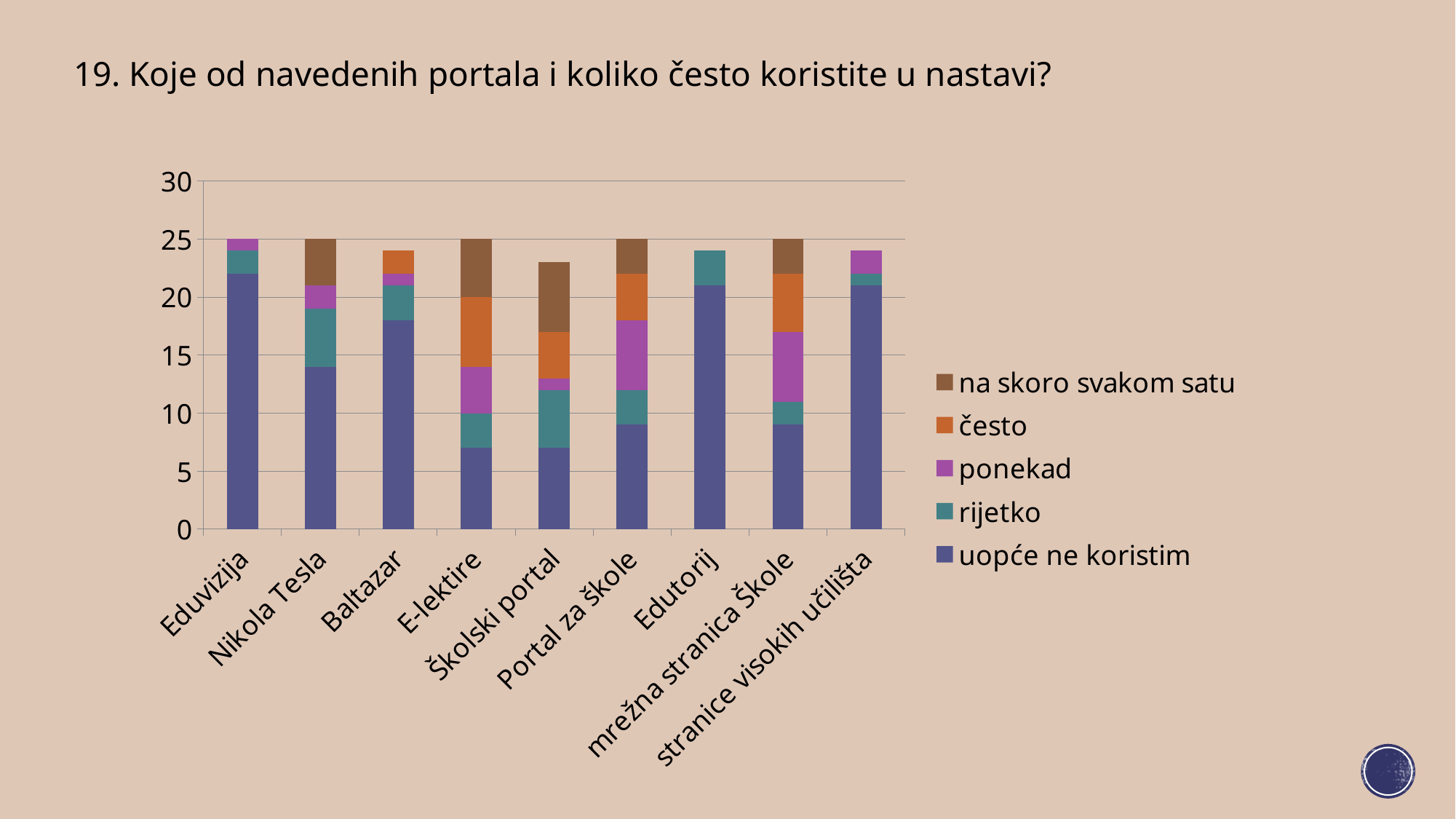
What is the total height of the stacked bar for Eduvizija? 25 Which legend entry is listed first (at the top) in the legend? na skoro svakom satu Is the 'uopće ne koristim' value for E-lektire greater or less than 10? less Which has a larger 'uopće ne koristim' value, Portal za škole or Eduvizija? Eduvizija Is the 'uopće ne koristim' value for Edutorij greater or less than 15? greater How many portals (categories) are shown on the x axis? 9 What is the total height of the stacked bar for Portal za škole? 25 How many series does the legend list? 5 What kind of chart is shown on the slide? stacked bar chart Which has a larger 'uopće ne koristim' value, Nikola Tesla or Baltazar? Baltazar Is the 'uopće ne koristim' value for Eduvizija greater or less than 20? greater